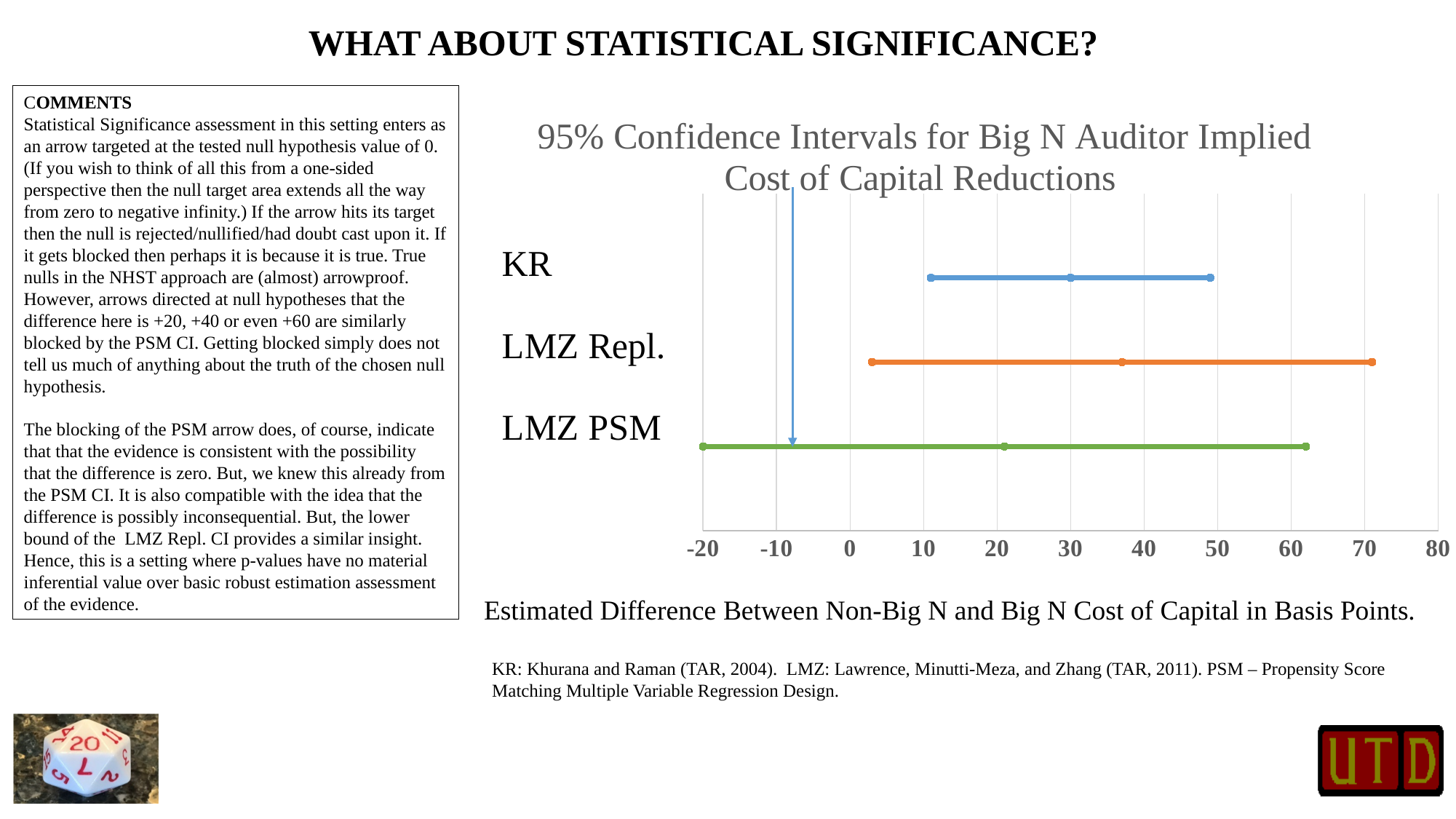
Which category has the lowest lower bound of its confidence interval? LMZ PSM What is the label of the horizontal axis below the chart? Estimated Difference Between Non-Big N and Big N Cost of Capital in Basis Points. Which category has the widest confidence interval? LMZ PSM Is the lower bound of the LMZ Repl. confidence interval greater or less than 0? greater Which confidence interval is the only one that includes 0? LMZ PSM Is the upper bound of the KR confidence interval larger or smaller than the upper bound of the LMZ Repl. confidence interval? smaller Which category has the highest upper bound of its confidence interval? LMZ Repl. Is the upper bound of the LMZ PSM confidence interval greater or less than 60? greater Is the lower bound of the LMZ PSM confidence interval greater or less than 0? less How many studies (categories) are plotted on the chart? 3 What is the title of the chart? 95% Confidence Intervals for Big N Auditor Implied Cost of Capital Reductions